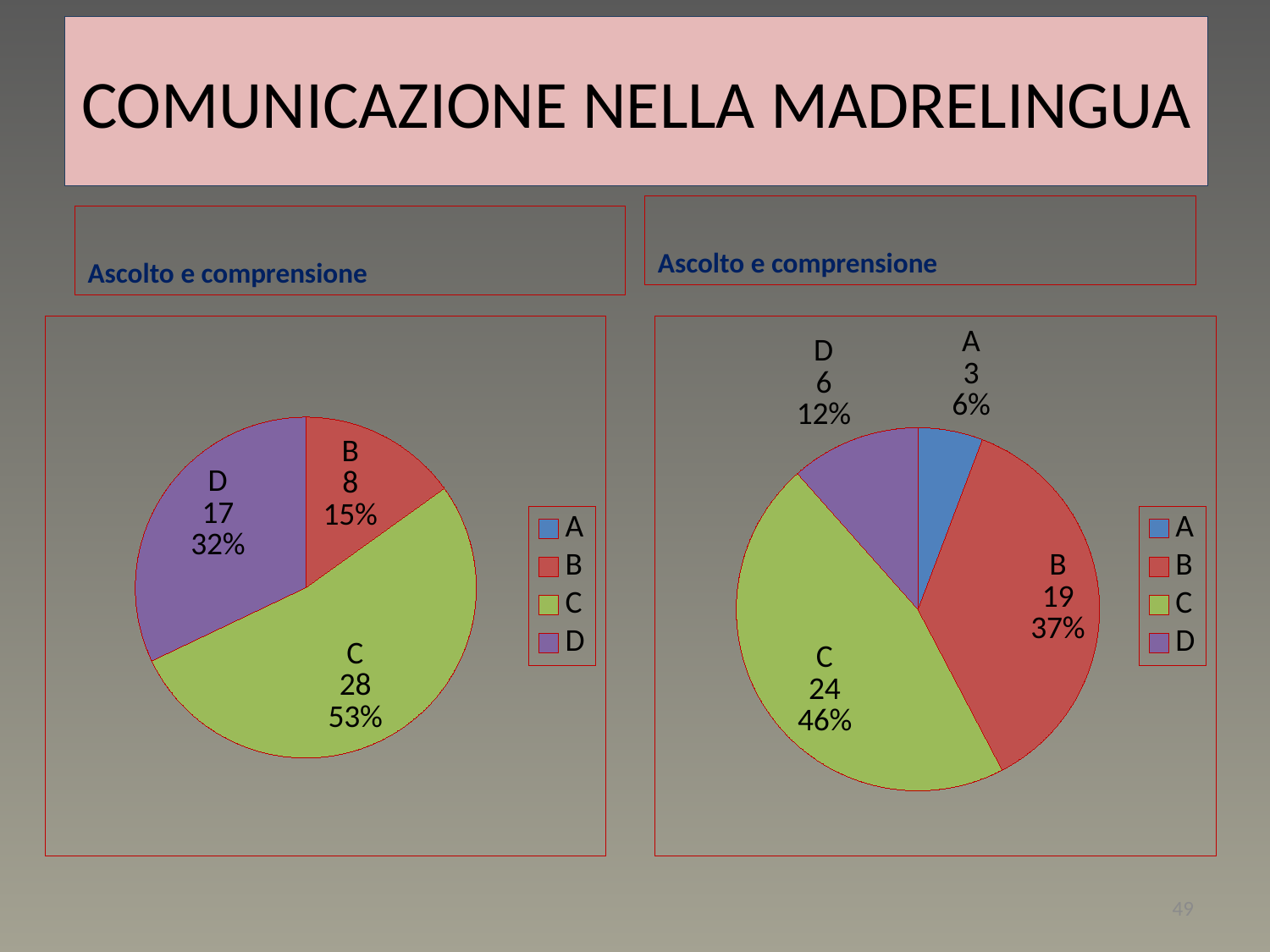
In the right pie chart, which category has the smallest slice? A In the left pie chart, what is the difference between the values for C and D? 11 How many entries does the legend of the right pie chart list? 4 In the right pie chart, which category has the largest slice? C In the left pie chart, which of the labelled categories has the smallest slice? B In the right pie chart, what percentage share does category A have? 6% What type of chart is shown on the left of the slide? Pie chart In the right pie chart, what is the value for category B? 19 In the left pie chart, what is the value for category C? 28 In the right pie chart, what is the difference between the values for C and B? 5 In the right pie chart, which is larger, the value for D or the value for A? D In the left pie chart, what percentage share does category D have? 32%